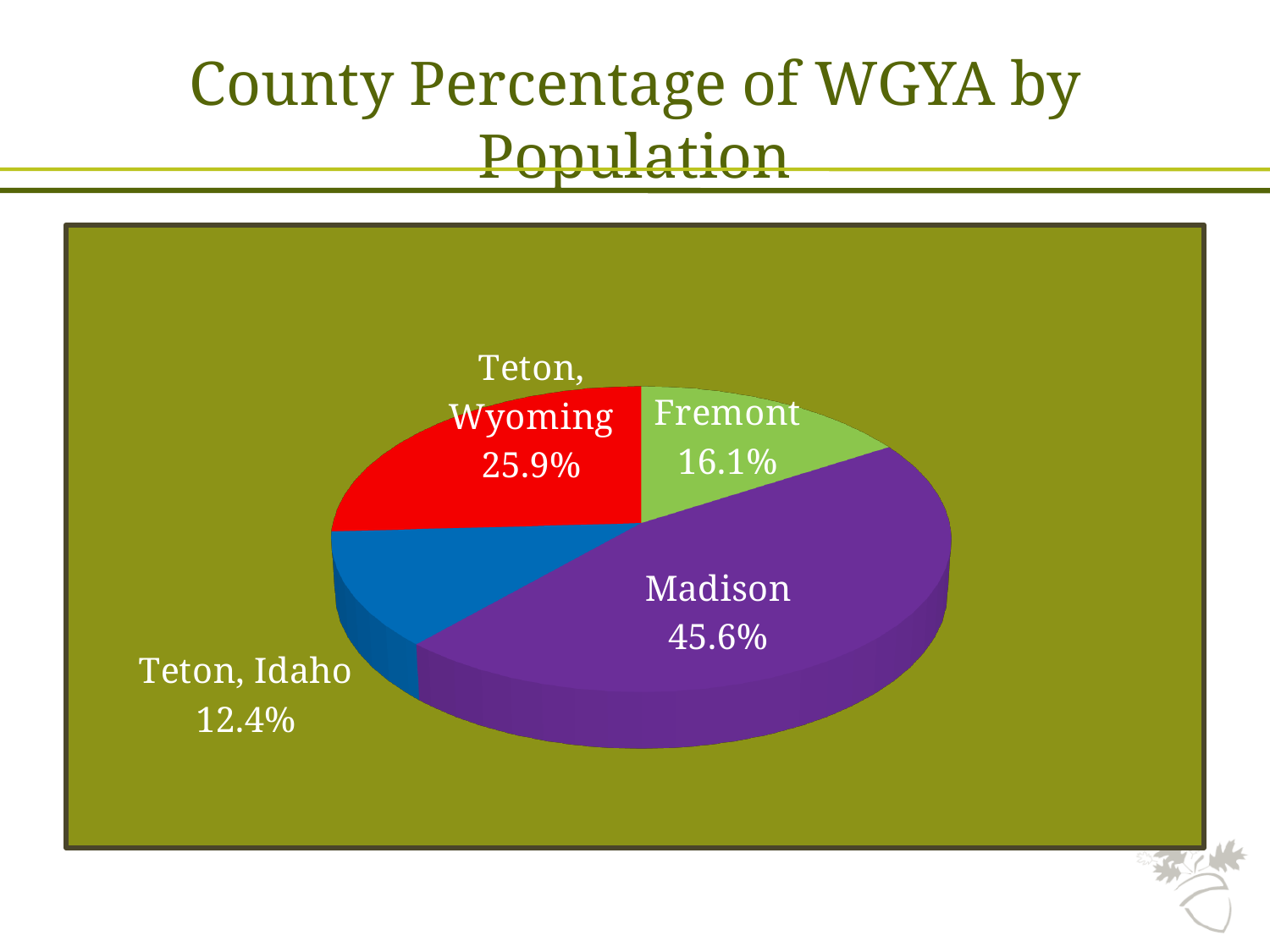
Which county has the smallest share of the pie chart? Teton, Idaho What percentage does Teton, Idaho account for in the pie chart? 12.4% What kind of chart is shown on the slide? Pie chart How many counties are shown in the pie chart? 4 What percentage does Madison account for in the pie chart? 45.6% What percentage does Fremont account for in the pie chart? 16.1% What is the difference in percentage points between Madison and Teton, Wyoming? 19.7 Which county has the largest share of the pie chart? Madison What percentage does Teton, Wyoming account for in the pie chart? 25.9% What is the title of the chart on the slide? County Percentage of WGYA by Population What is the difference in percentage points between Fremont and Teton, Idaho? 3.7 Which has a larger share, Fremont or Teton, Wyoming? Teton, Wyoming